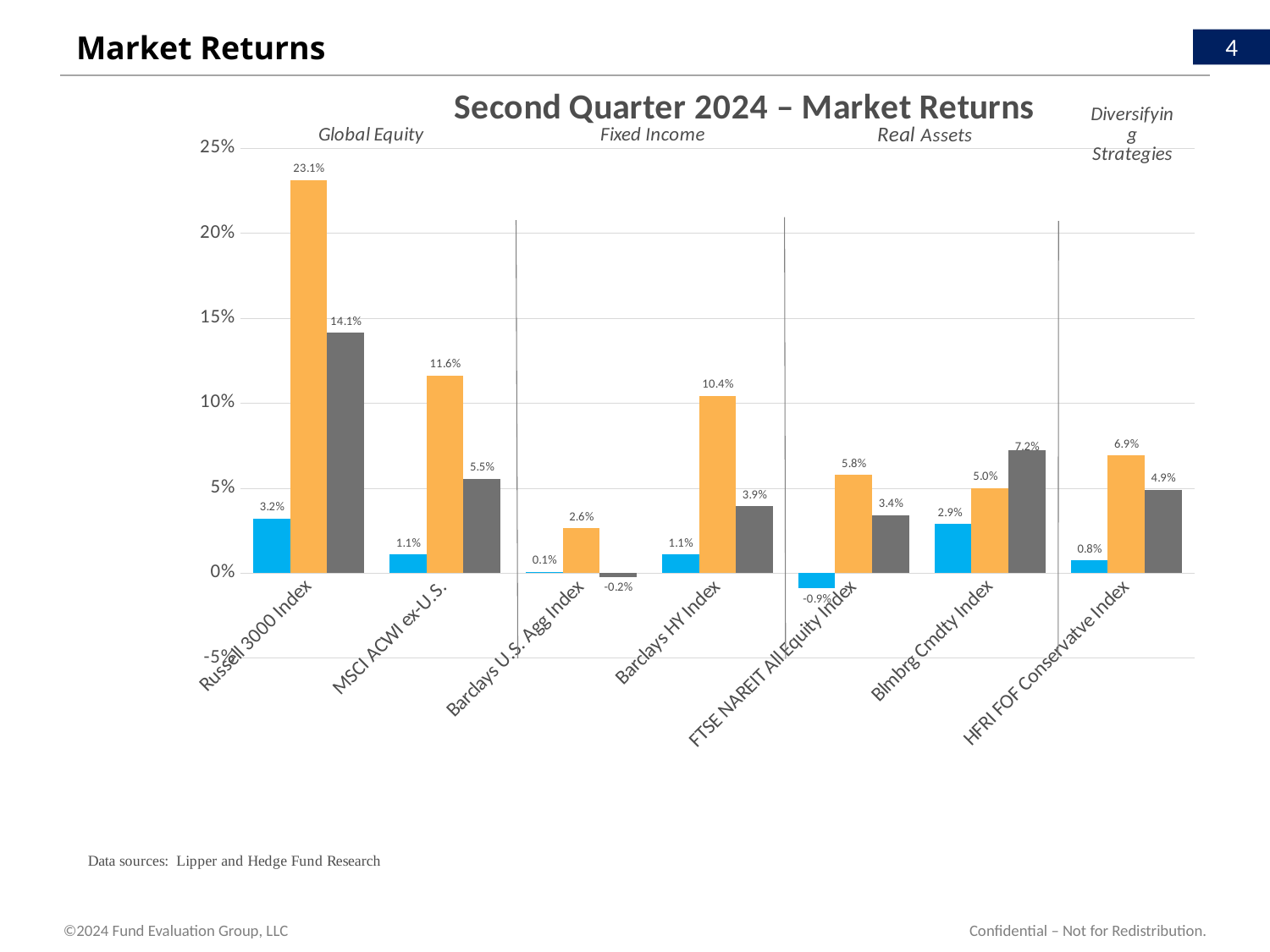
What is the difference between the orange bars for MSCI ACWI ex-U.S. and Barclays HY Index? 1.2% What is the title of the chart? Second Quarter 2024 – Market Returns What is the value of the grey bar for Blmbrg Cmdty Index? 7.2% What is the value of the orange bar for Russell 3000 Index? 23.1% Is the orange bar for Russell 3000 Index greater or less than 20%? greater Which is larger for Blmbrg Cmdty Index, the orange bar or the grey bar? the grey bar Which category has the highest orange bar? Russell 3000 Index What is the value of the grey bar for Barclays U.S. Agg Index? -0.2% How many index categories are shown on the x axis? 7 What is the difference between the orange bar and the grey bar for Russell 3000 Index? 9.0% Which category has the lowest blue bar? FTSE NAREIT All Equity Index What is the value of the blue bar for FTSE NAREIT All Equity Index? -0.9%